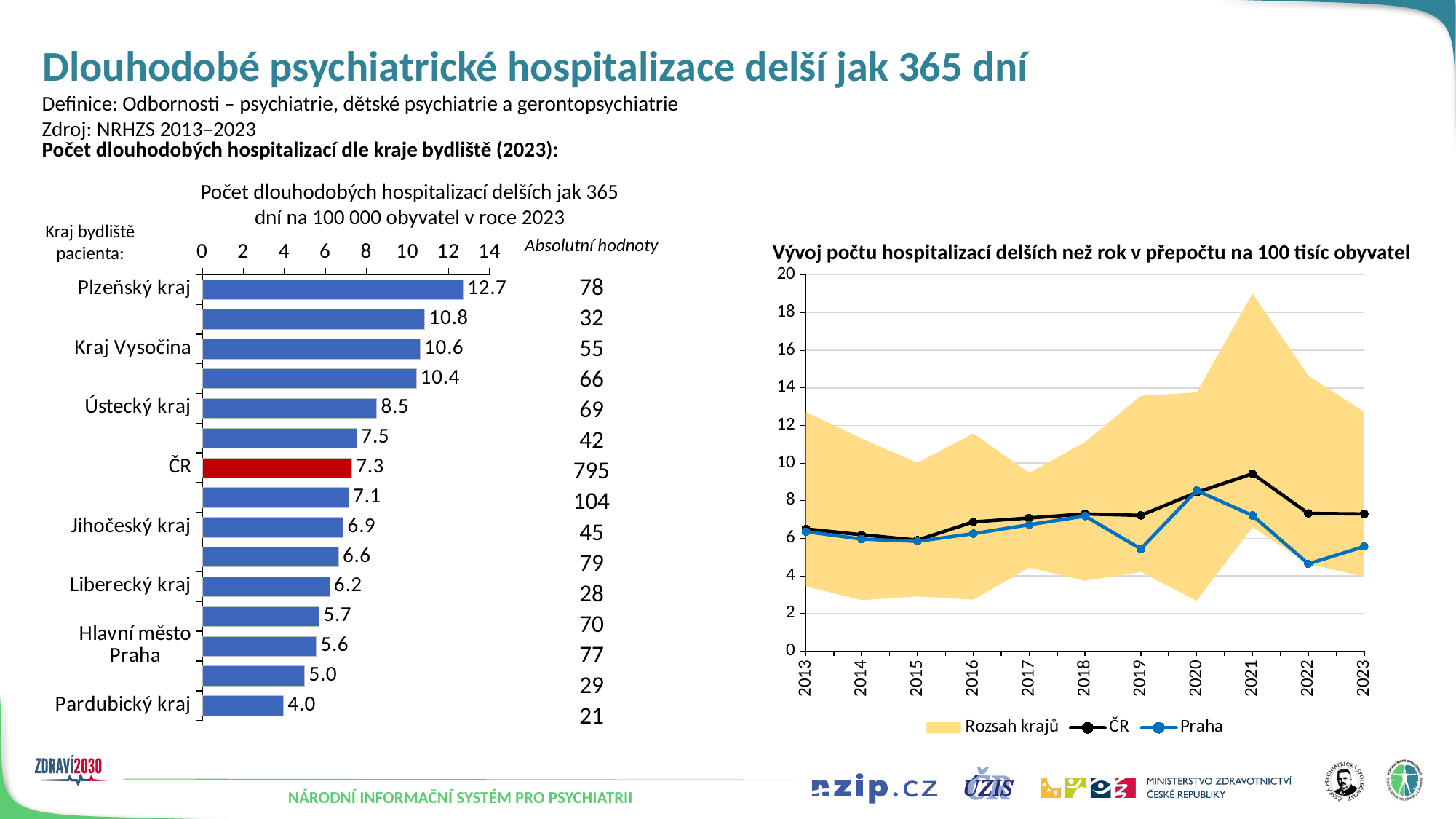
On the left bar chart, what is the value for Pardubický kraj? 4.0 On the right chart, how many series does the legend list? 3 On the left bar chart, what is the value for ČR? 7.3 On the left bar chart, which region has the lowest value? Pardubický kraj On the left bar chart, which is larger, the value for Ústecký kraj or the value for Jihočeský kraj? Ústecký kraj On the left bar chart, what is the value for Plzeňský kraj? 12.7 On the left bar chart, what is the difference between the values for Plzeňský kraj and Kraj Vysočina? 2.1 On the left bar chart, what is the absolute value (Absolutní hodnoty) shown for ČR? 795 On the right chart, which is larger in 2021, the value for ČR or the value for Praha? ČR On the left bar chart, how many bars are plotted? 15 On the left bar chart, which region has the highest value? Plzeňský kraj On the right chart, is the value for ČR in 2021 greater or less than 8? greater